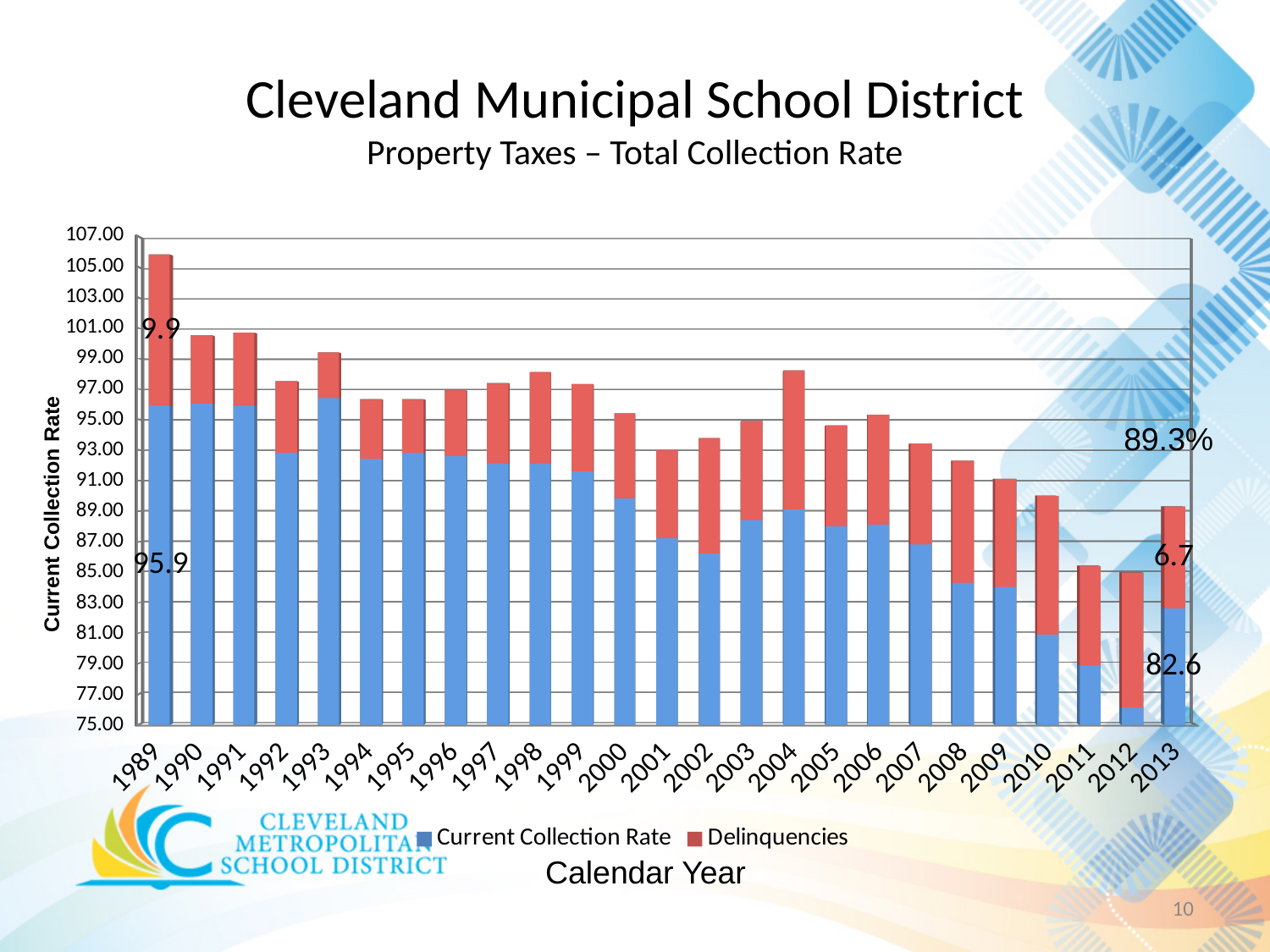
Is the Current Collection Rate for 2012 greater or less than 79? less What is the Current Collection Rate for 2013? 82.6 What is the Delinquencies value for 2013? 6.7 How many series does the legend list? 2 Which year has the lowest Current Collection Rate? 2012 What is the total collection rate shown for the 2013 bar? 89.3% What is the Delinquencies value for 1989? 9.9 Does the Current Collection Rate generally rise or fall from 1989 to 2013? fall What is the Current Collection Rate for 1989? 95.9 What kind of chart is shown on the slide? stacked bar chart How many calendar years are shown on the x axis? 25 What is the difference between the Current Collection Rate in 1989 and in 2013? 13.3